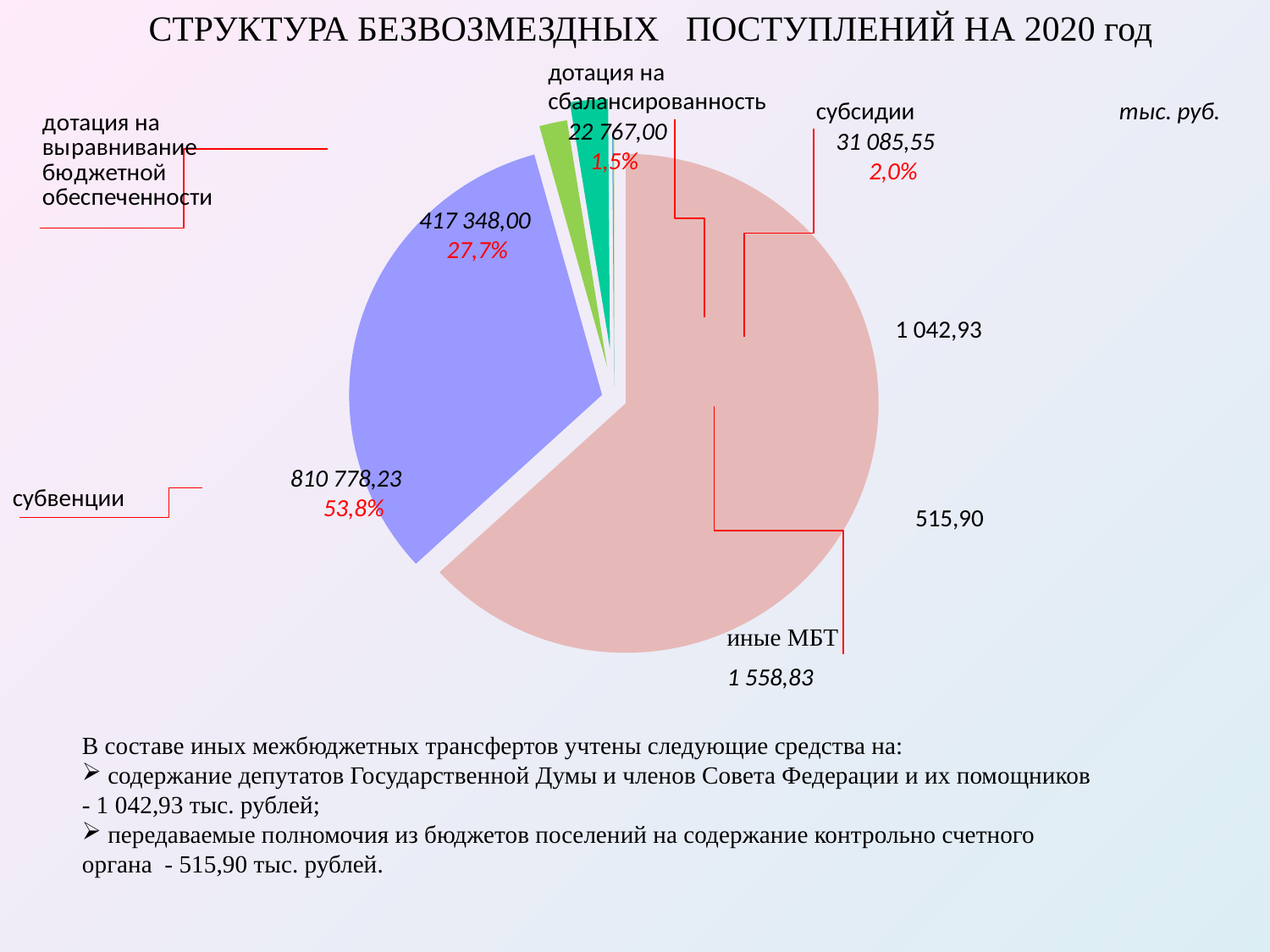
What is the value shown for иные МБТ? 1 558,83 What is the difference between the value for субсидии and the value for дотация на сбалансированность? 8 318,55 What value is labelled with the share 53,8%? 810 778,23 What percentage share is shown for дотация на сбалансированность? 1,5% Which is larger, the value for субсидии or the value for дотация на сбалансированность? субсидии In what units are the values on the chart given? тыс. руб. What kind of chart is shown on the slide? pie chart What is the title of the chart? СТРУКТУРА БЕЗВОЗМЕЗДНЫХ ПОСТУПЛЕНИЙ НА 2020 год What percentage share is shown for субсидии? 2,0% What value is labelled with the share 27,7%? 417 348,00 What is the value shown for дотация на сбалансированность? 22 767,00 What is the value shown for субсидии? 31 085,55